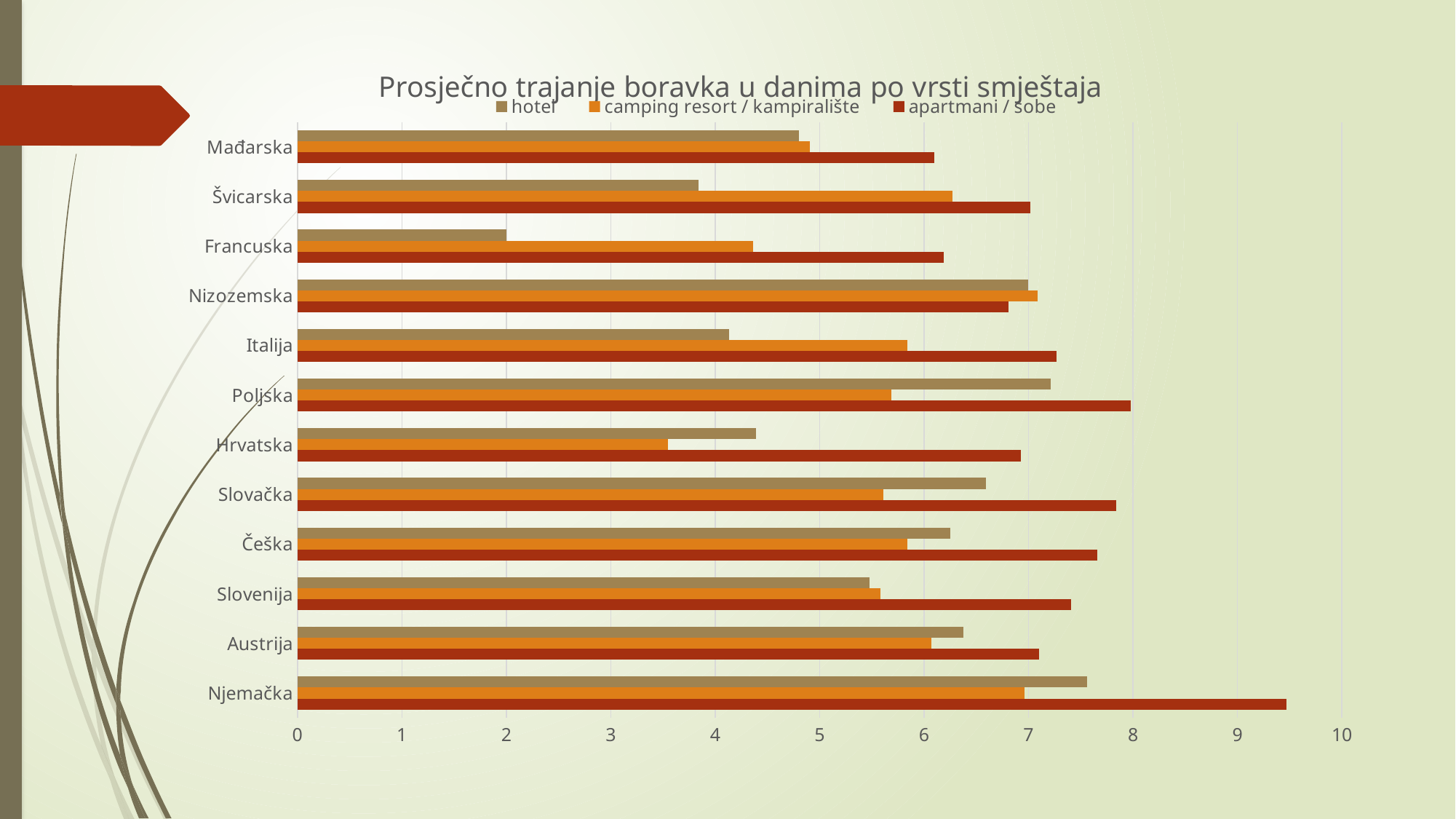
Is the apartmani / sobe value for Njemačka greater or less than 9? greater What kind of chart is shown on the slide? bar chart Which country has the lowest value for hotel? Francuska Which country has the lowest value for camping resort / kampiralište? Hrvatska Which series is shown in dark red? apartmani / sobe For Hrvatska, which is larger: the hotel value or the camping resort / kampiralište value? hotel What is the title of the chart? Prosječno trajanje boravka u danima po vrsti smještaja How many countries are shown on the chart? 12 Which country has the highest value for apartmani / sobe? Njemačka Is the hotel value for Francuska greater or less than 3? less Is the camping resort / kampiralište value for Hrvatska greater or less than 4? less How many series does the legend list? 3